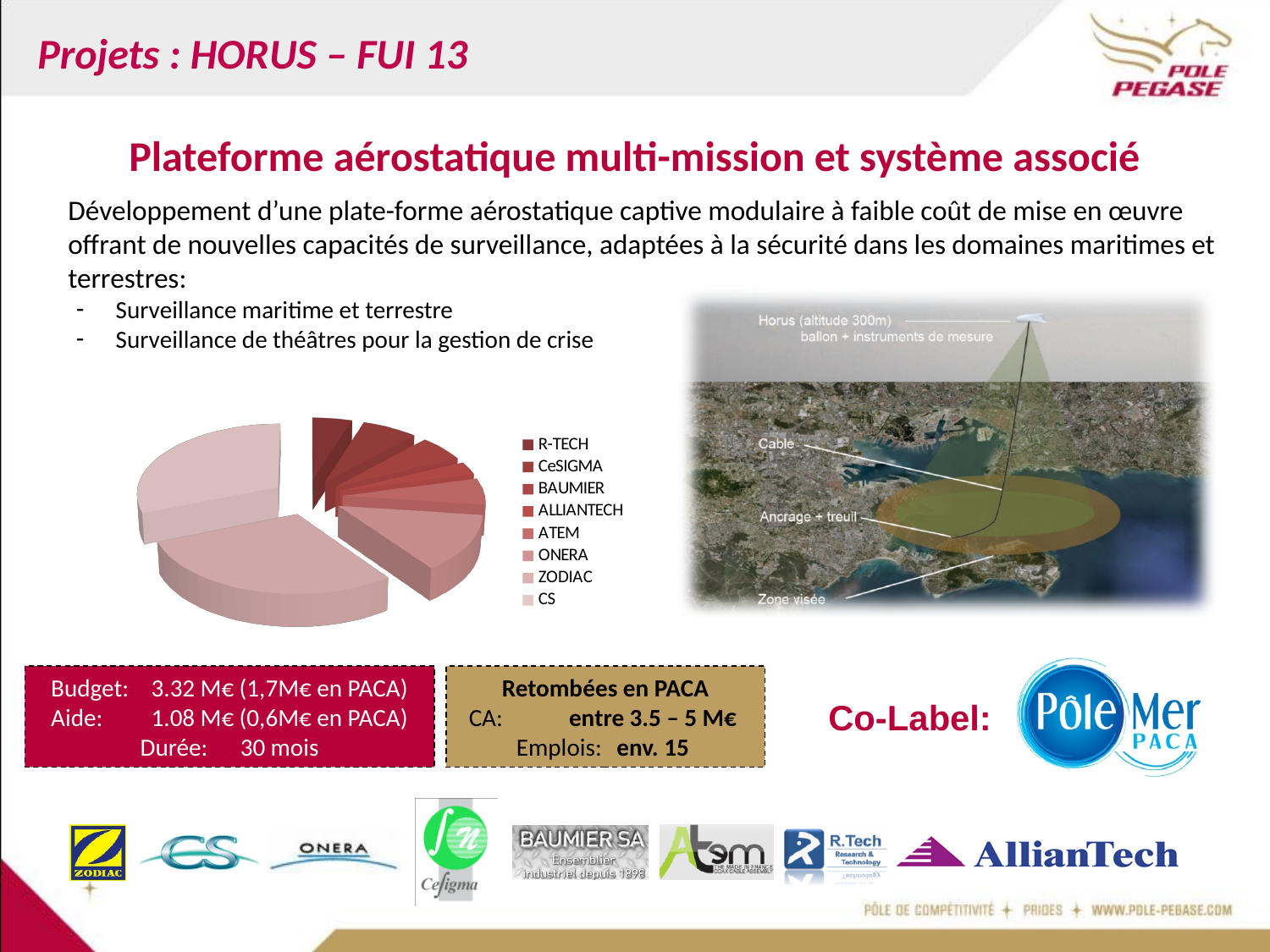
In the pie chart, which slice is larger, CS or BAUMIER? CS In the pie chart, which slice is larger, CS or R-TECH? CS What kind of chart is shown on the slide? pie chart In the pie chart, which slice is larger, ZODIAC or ATEM? ZODIAC How many categories does the pie chart's legend list? 8 Which category is listed last in the pie chart's legend? CS Which category is listed first in the pie chart's legend? R-TECH